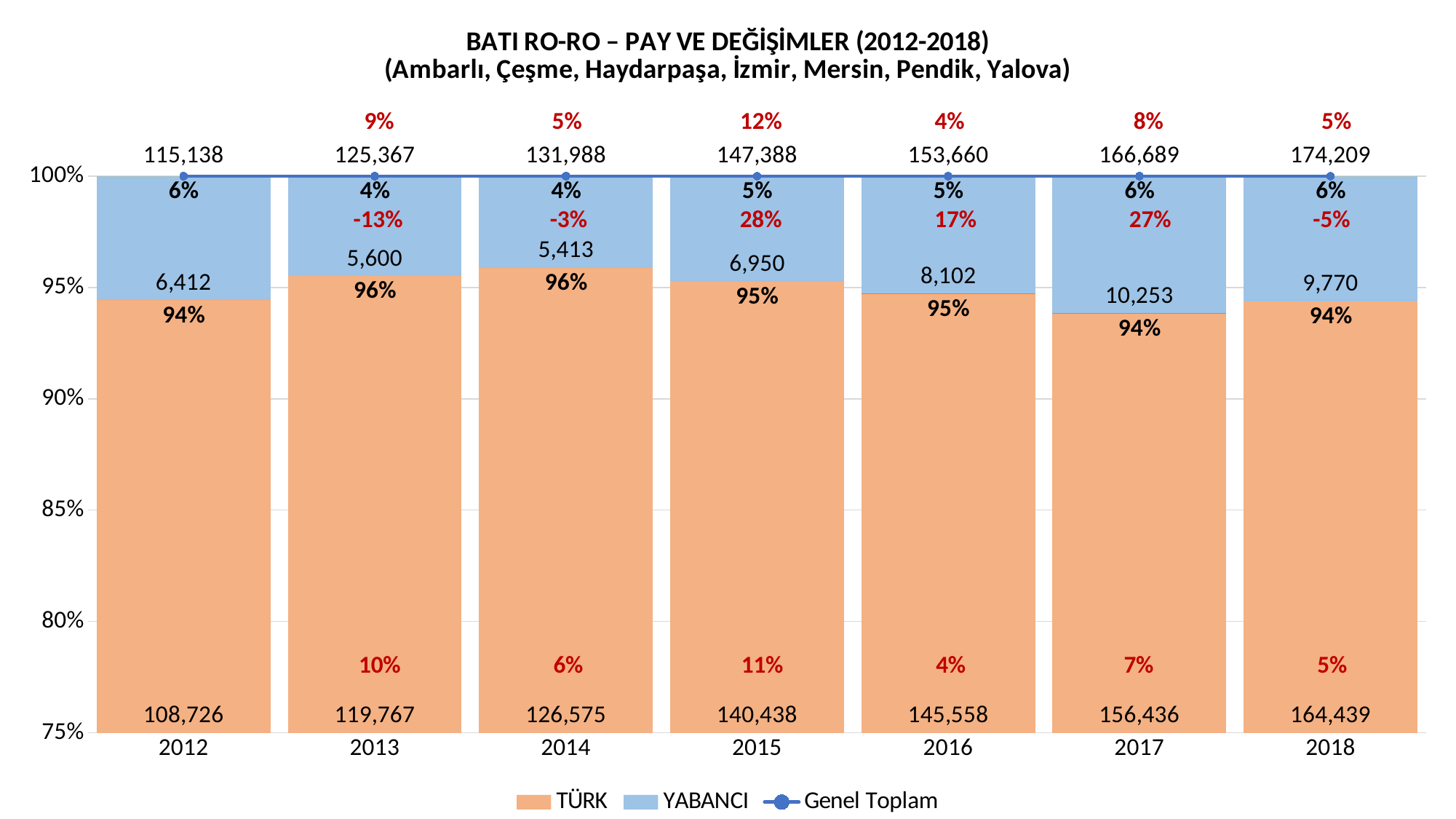
What kind of chart is shown on the slide? combination stacked bar and line chart What is the difference between the Genel Toplam values for 2018 and 2012? 59,071 Which year has the lowest YABANCI value? 2014 What is the YABANCI value for 2017? 10,253 How many years are shown on the x axis? 7 Which year has the highest Genel Toplam value? 2018 What is the TÜRK value for 2015? 140,438 Does the Genel Toplam value rise or fall from 2012 to 2018? rises What percentage share does TÜRK have in 2013? 96% Which year has the larger YABANCI value, 2013 or 2014? 2013 How many series does the legend list? 3 What is the Genel Toplam value for 2018? 174,209